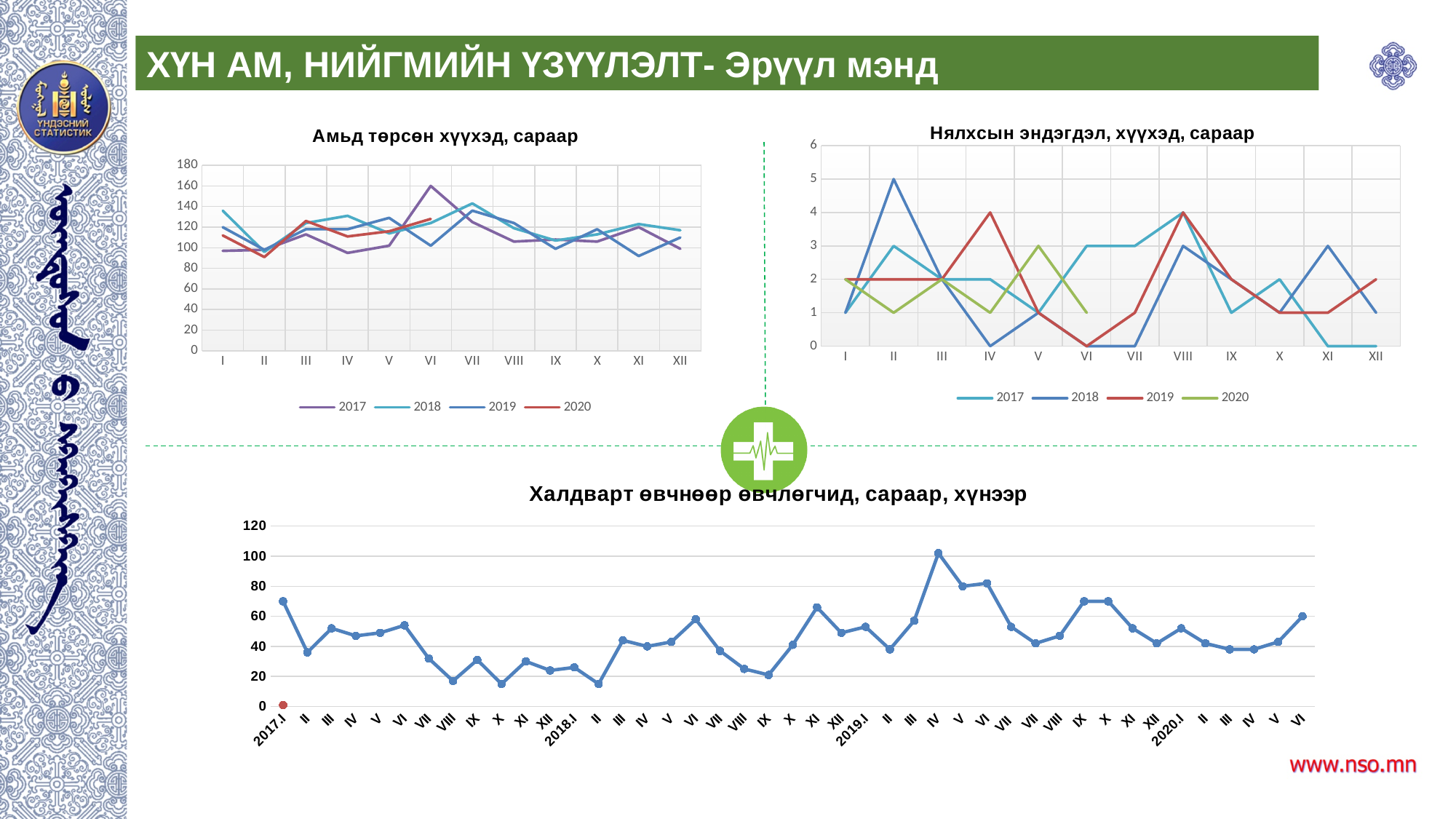
What kind of chart is the 'Амьд төрсөн хүүхэд, сараар' chart? line chart In the 'Амьд төрсөн хүүхэд, сараар' chart, is the 2017 value for month VI greater or less than 140? greater In the 'Нялхсын эндэгдэл, хүүхэд, сараар' chart, which is larger in month II: the 2018 value or the 2019 value? 2018 In the 'Нялхсын эндэгдэл, хүүхэд, сараар' chart, what is the 2018 value for month IV? 0 In the 'Нялхсын эндэгдэл, хүүхэд, сараар' chart, what is the 2019 value for month IV? 4 In the 'Нялхсын эндэгдэл, хүүхэд, сараар' chart, which year has the highest value in month II? 2018 In the 'Нялхсын эндэгдэл, хүүхэд, сараар' chart, what is the 2018 value for month II? 5 How many months are shown on the x axis of the 'Амьд төрсөн хүүхэд, сараар' chart? 12 How many series does the legend of the 'Амьд төрсөн хүүхэд, сараар' chart list? 4 In the 'Халдварт өвчнөөр өвчлөгчид, сараар, хүнээр' chart, which month has the highest value? 2019.IV In the 'Амьд төрсөн хүүхэд, сараар' chart, which year has the highest value in month VI? 2017